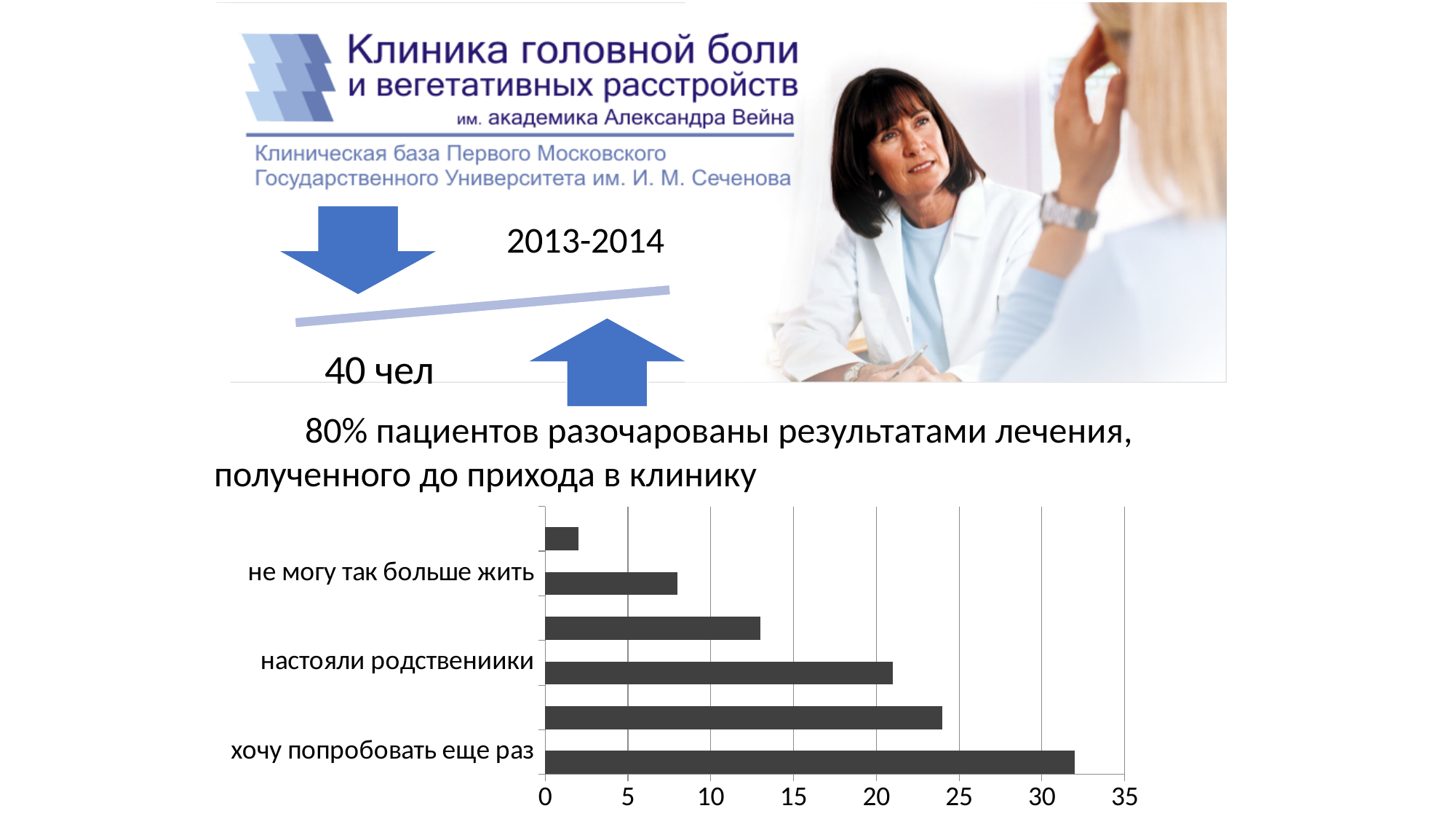
Which labeled category has the shortest bars in the chart? не могу так больше жить Is the value of the shortest bar in the chart greater or less than 5? less What is the highest value shown on the horizontal axis of the chart? 35 Is the value of the longest bar in the chart greater or less than 30? greater Do the bars get longer or shorter going from the top of the chart to the bottom? longer Is the value for "хочу попробовать еще раз" greater or less than 20? greater Which labeled category has the longest bar in the chart? хочу попробовать еще раз What kind of chart is shown at the bottom of the slide? bar chart What is the interval between tick marks on the horizontal axis of the chart? 5 How many bars are plotted in the chart? 6